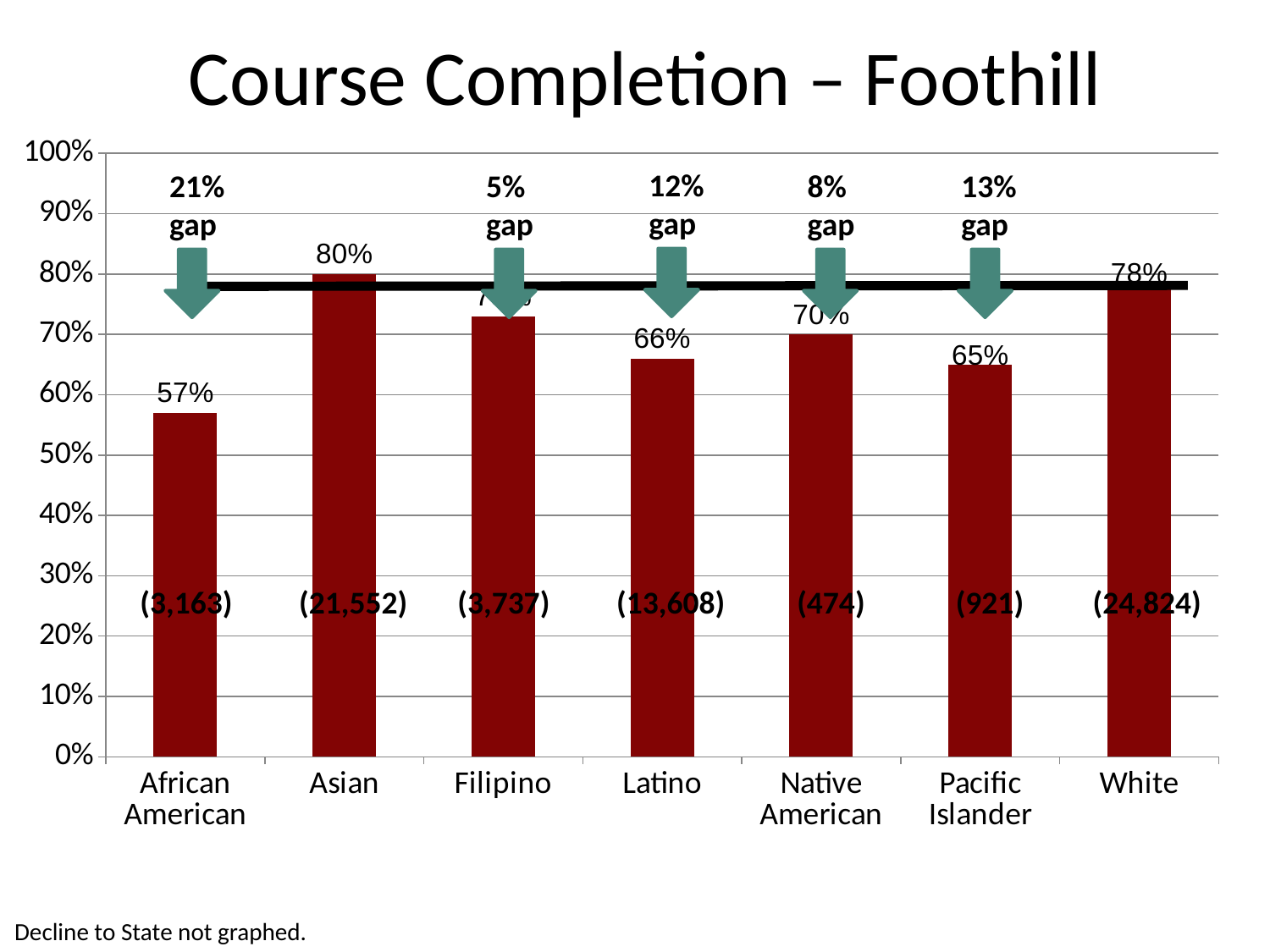
What is the course completion rate for Latino students? 66% What is the difference between the course completion rates of Asian and African American students? 23% What is the course completion rate for Asian students? 80% Which group has a higher course completion rate, Native American or Pacific Islander? Native American What kind of chart is shown on the slide? bar chart Which group has the lowest course completion rate? African American How many groups are shown on the x axis of the chart? 7 What is the course completion rate for African American students? 57% What is the course completion rate for White students? 78% What gap is labeled above the African American bar? 21% gap Which group has the highest course completion rate? Asian Is the course completion rate for Filipino students greater or less than 70%? greater